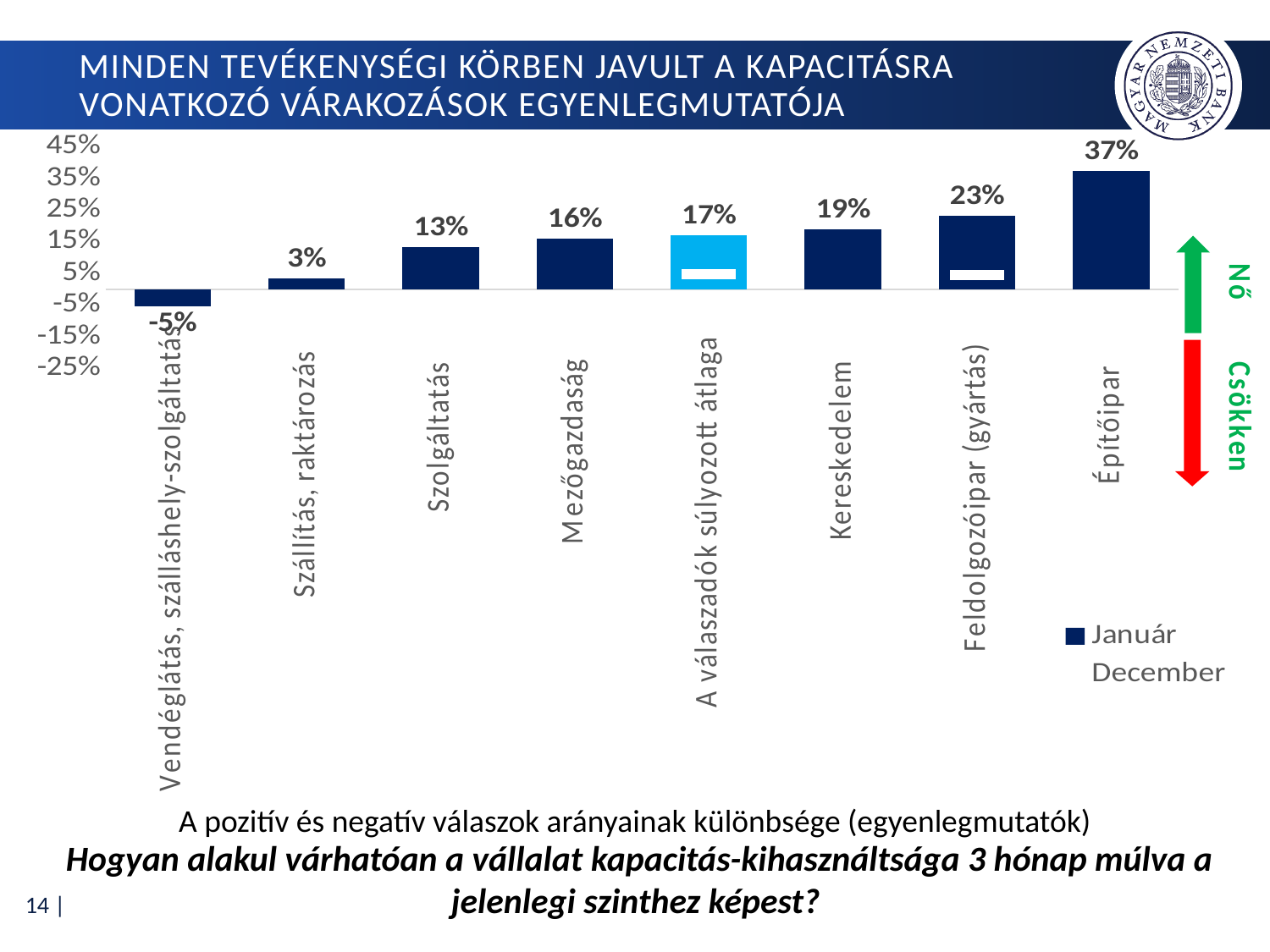
Which has the larger Január value, Szolgáltatás or Mezőgazdaság? Mezőgazdaság How many series does the legend list? 2 What is the Január value for Vendéglátás, szálláshely-szolgáltatás? -5% Which category has the highest Január value? Építőipar What is the difference between the Január values for Építőipar and Feldolgozóipar (gyártás)? 14% What is the Január value for Építőipar? 37% Is the Január value for Feldolgozóipar (gyártás) greater or less than 15%? greater Which category has the lowest Január value? Vendéglátás, szálláshely-szolgáltatás What kind of chart is shown on the slide? bar chart What is the Január value for A válaszadók súlyozott átlaga? 17% How many categories are shown on the x axis? 8 What is the Január value for Kereskedelem? 19%